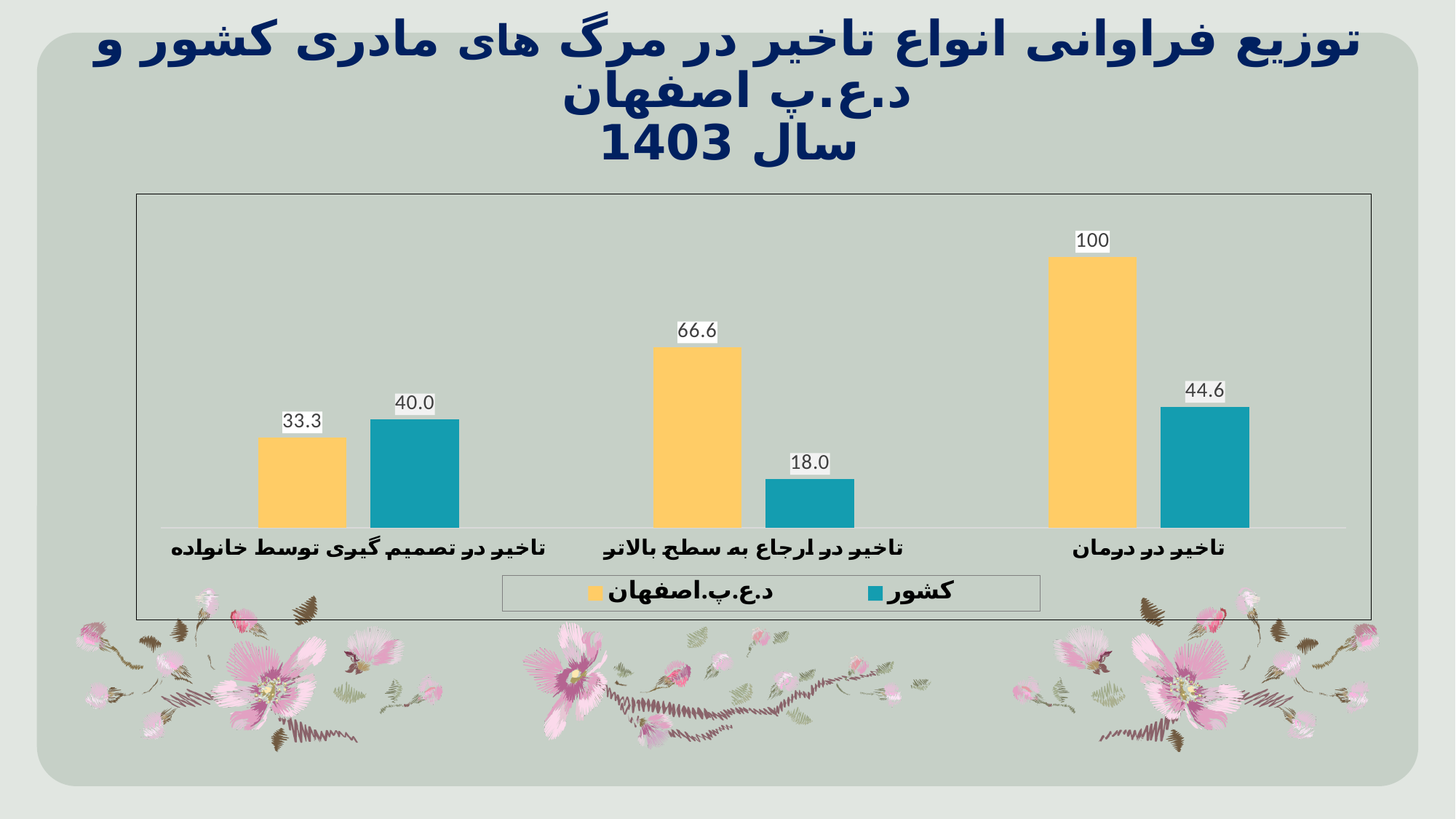
How many series does the legend list? 2 In the category تاخیر در تصمیم گیری توسط خانواده, which series has the larger value, د.ع.پ اصفهان or کشور? کشور How many categories are shown on the x axis? 3 What kind of chart is shown on the slide? bar chart Which category has the lowest value for the د.ع.پ اصفهان series? تاخیر در تصمیم گیری توسط خانواده What is the value for د.ع.پ اصفهان in the category تاخیر در درمان? 100 What is the value for کشور in the category تاخیر در ارجاع به سطح بالاتر? 18.0 Which category has the highest value for the کشور series? تاخیر در درمان What is the value for کشور in the category تاخیر در درمان? 44.6 What colour are the bars for the کشور series? teal What is the value for د.ع.پ اصفهان in the category تاخیر در تصمیم گیری توسط خانواده? 33.3 What is the difference between the د.ع.پ اصفهان and کشور values in the category تاخیر در ارجاع به سطح بالاتر? 48.6